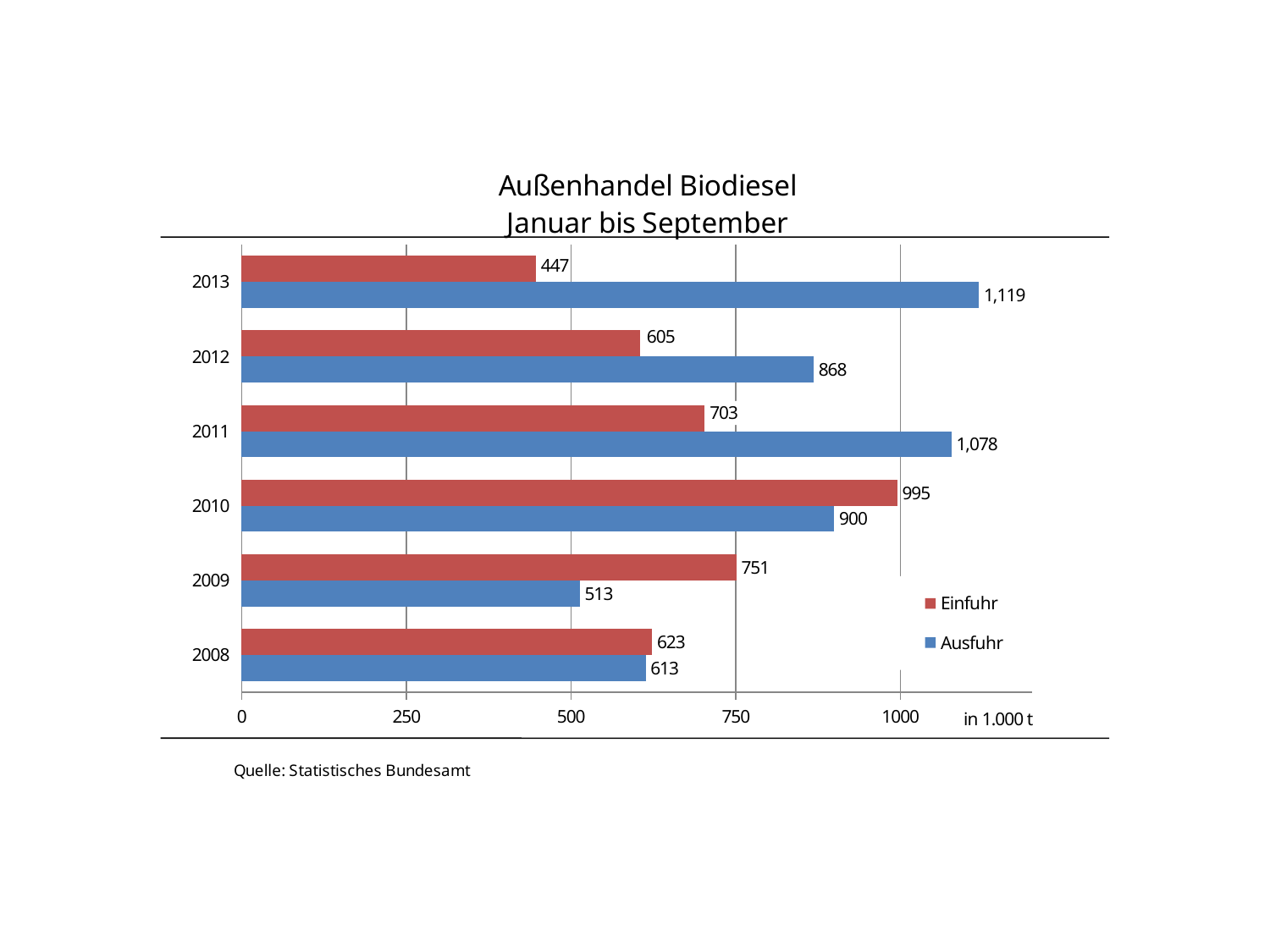
What is the Ausfuhr value for 2009? 513 Which year has the highest Ausfuhr value? 2013 Is the Ausfuhr value for 2012 greater or less than 750? greater How many years are shown on the chart? 6 What kind of chart is shown? bar chart Which is larger in 2010, Einfuhr or Ausfuhr? Einfuhr Which year has the lowest Einfuhr value? 2013 What is the Einfuhr value for 2013? 447 What is the difference between Ausfuhr and Einfuhr in 2013? 672 How many series does the legend list? 2 What is the unit given on the x axis? in 1.000 t What is the Ausfuhr value for 2011? 1,078